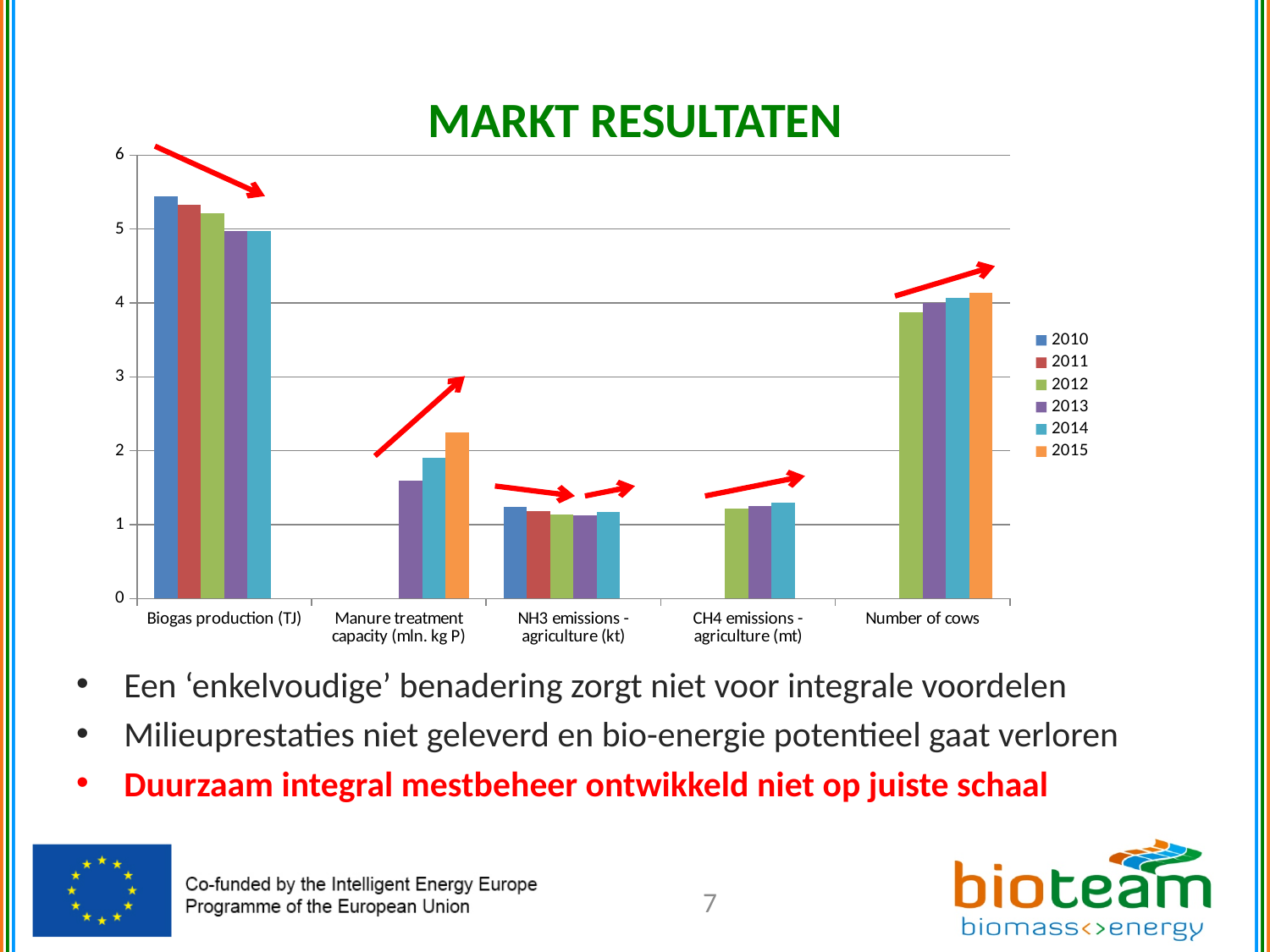
What kind of chart is shown on the slide? bar chart Is the value for Number of cows in 2012 greater or less than 4? less Do the values for Manure treatment capacity (mln. kg P) rise or fall from 2013 to 2015? rise Is the value for Biogas production (TJ) in 2010 greater or less than 5? greater How many categories are shown on the x axis of the chart? 5 Which year has the lowest value for Number of cows? 2012 Do the values for Biogas production (TJ) rise or fall from 2010 to 2014? fall Which year has the highest value for Manure treatment capacity (mln. kg P)? 2015 Which is larger: the 2015 value for Manure treatment capacity (mln. kg P) or the 2014 value for CH4 emissions - agriculture (mt)? Manure treatment capacity (mln. kg P) in 2015 Which year does the orange series in the legend represent? 2015 What is the title of the chart? MARKT RESULTATEN How many series does the chart legend list? 6